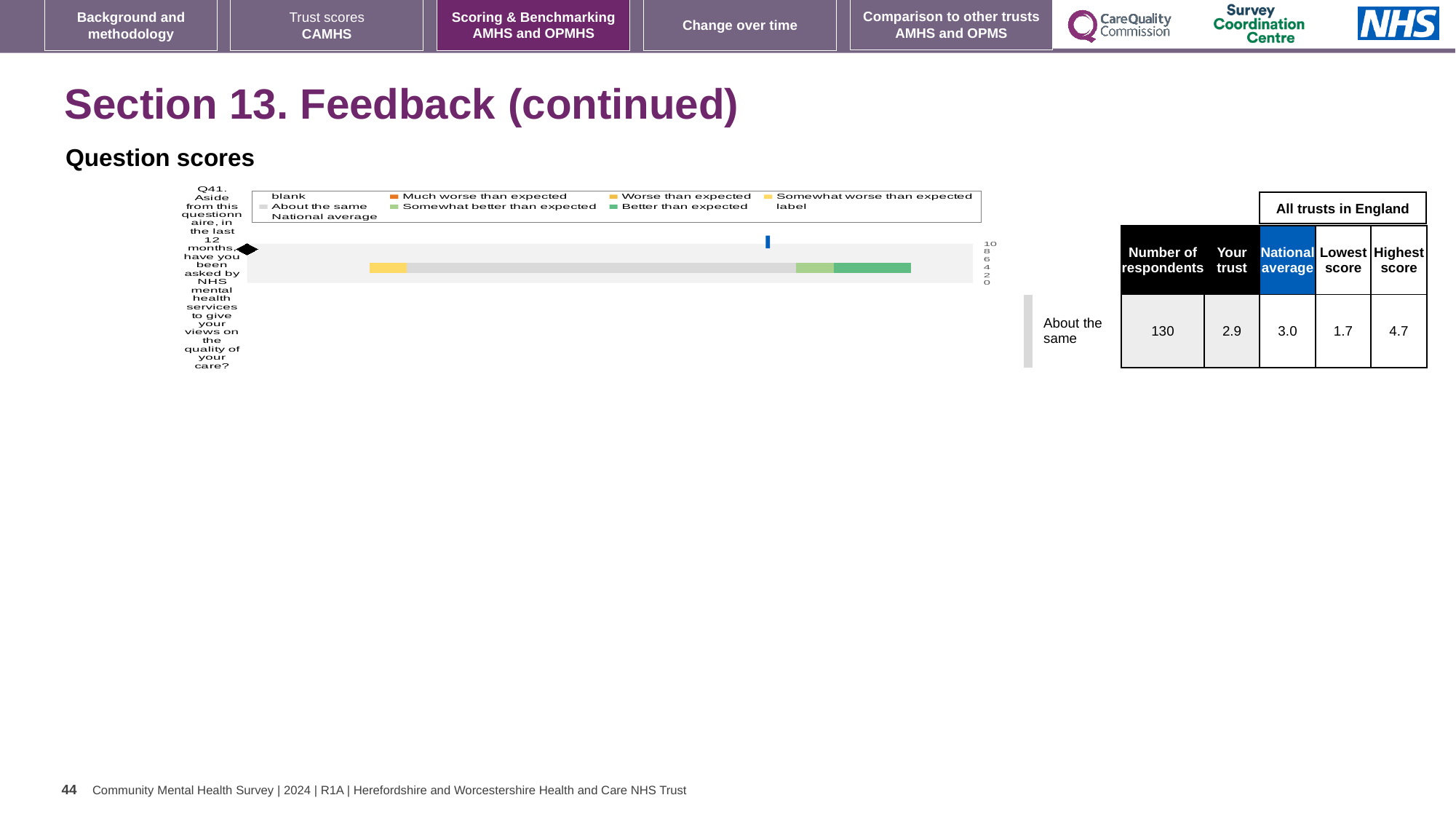
How many questions (categories) are plotted in the chart? 1 According to the table beside the chart, what is the 'Your trust' score for Q41? 2.9 What is the difference between the highest score and the lowest score for Q41? 3.0 According to the table beside the chart, what is the lowest score among all trusts in England for Q41? 1.7 What benchmark category is the trust's Q41 score assigned to on the slide? About the same Which question number is plotted in the chart? Q41 Which is larger for Q41: the 'Your trust' score or the national average? National average According to the table beside the chart, what is the national average score for Q41? 3.0 According to the table beside the chart, what is the highest score among all trusts in England for Q41? 4.7 According to the table beside the chart, what is the number of respondents for Q41? 130 What colour is the 'Better than expected' legend entry in the chart? green What kind of chart is shown on the slide? bar chart